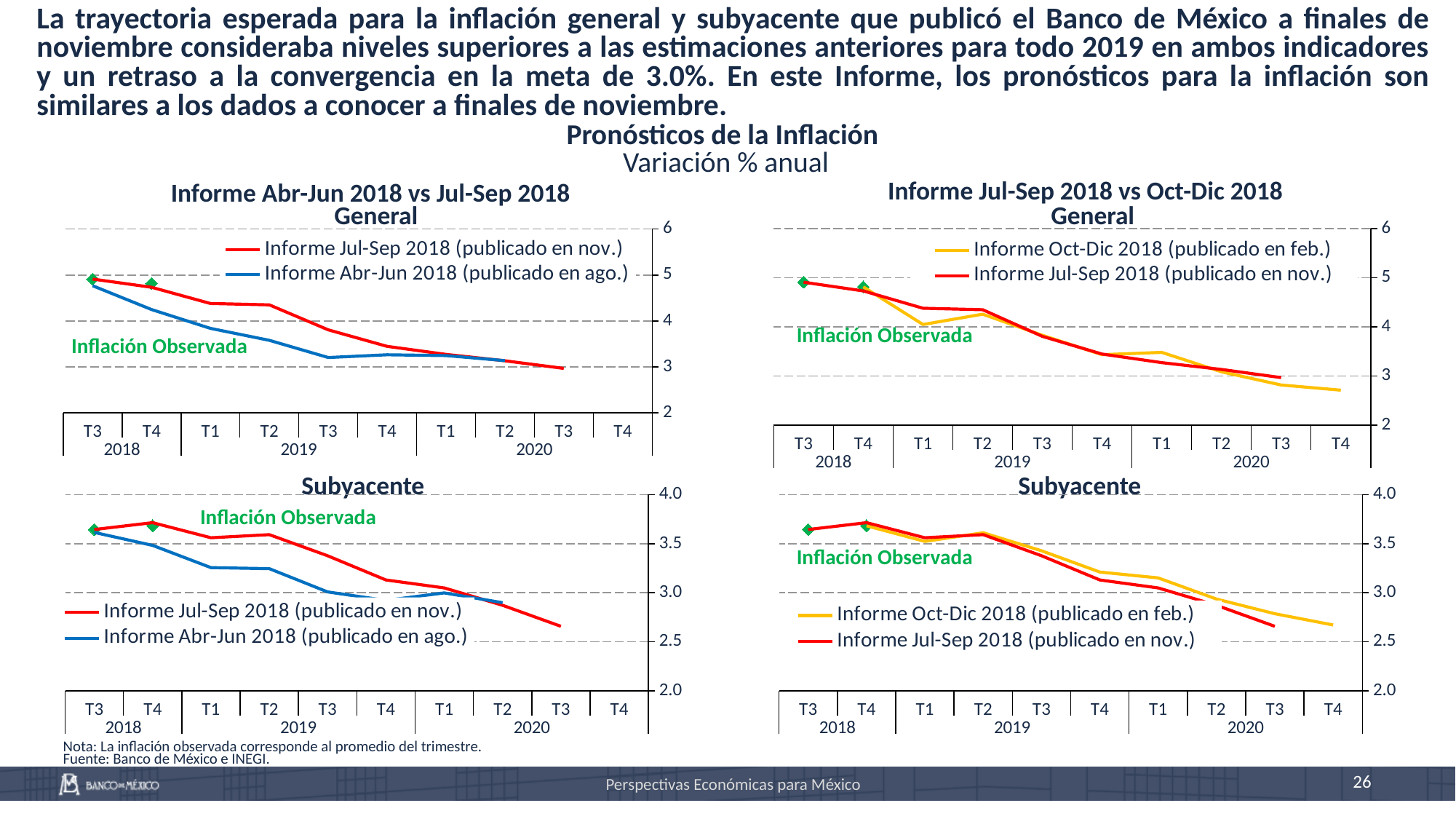
In the top-right General chart, does the Informe Jul-Sep 2018 line generally rise or fall from T3 2018 to T3 2020? Fall In the bottom-right Subyacente chart, is the value of the Informe Oct-Dic 2018 line at T4 2019 greater or less than 3.5? less How many quarters are labelled on the x axis of the bottom-left Subyacente chart? 10 How many series does the legend list in the top-right chart (Informe Jul-Sep 2018 vs Oct-Dic 2018, General)? 2 What kind of chart is the top-left chart (Informe Abr-Jun 2018 vs Jul-Sep 2018, General)? Line chart In the top-left General chart, is the value of the Informe Jul-Sep 2018 line at T3 2018 greater or less than 4? greater In the top-left General chart, is the value of the Informe Abr-Jun 2018 line at T3 2019 greater or less than 4? less In the top-left General chart, which line is higher at T1 2019: Informe Jul-Sep 2018 or Informe Abr-Jun 2018? Informe Jul-Sep 2018 In the top-right General chart, what colour is the Informe Oct-Dic 2018 (publicado en feb.) line? Yellow In the bottom-right Subyacente chart, which line is higher at T3 2020: Informe Oct-Dic 2018 or Informe Jul-Sep 2018? Informe Oct-Dic 2018